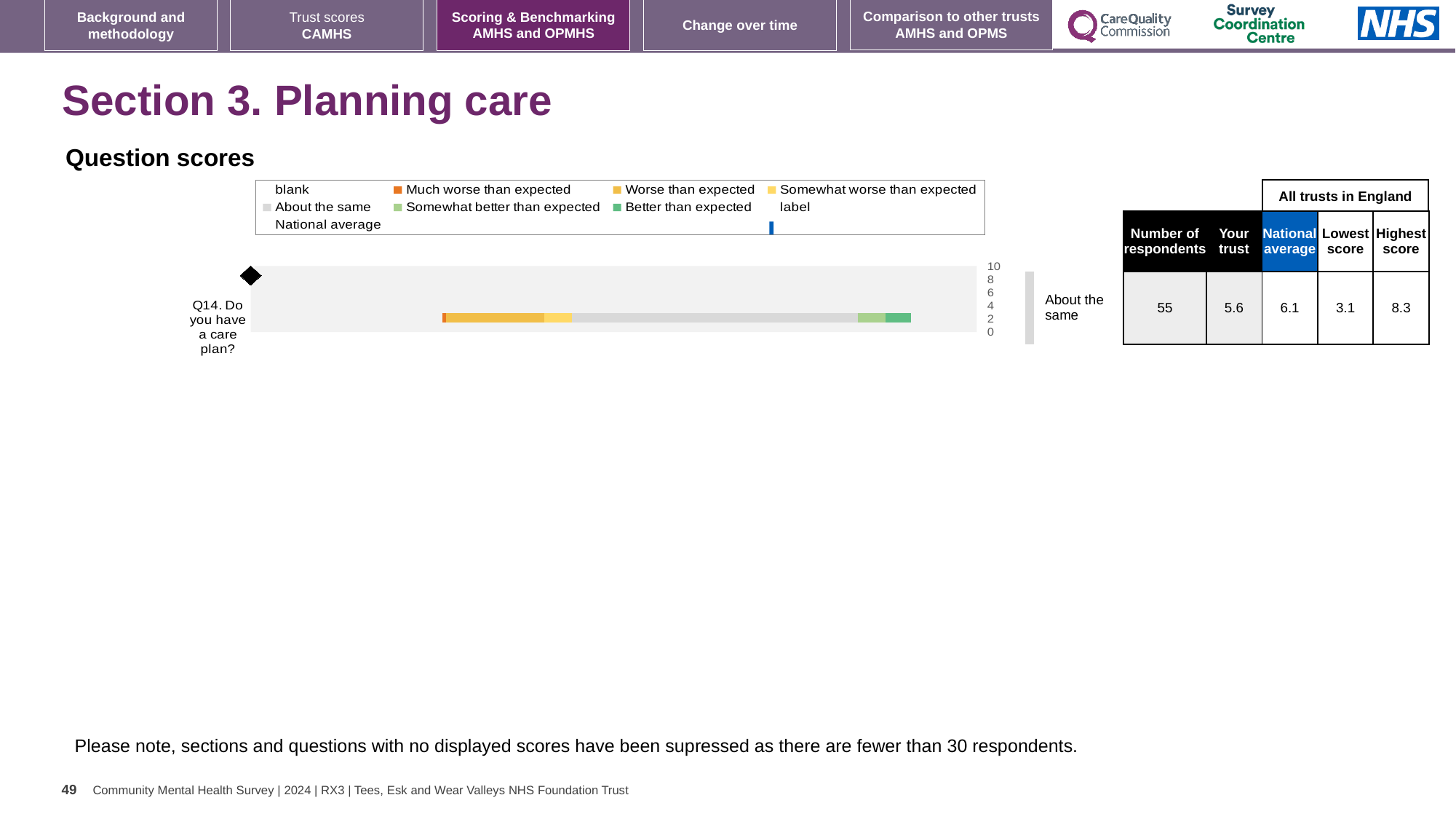
What is the highest score among all trusts in England for Q14? 8.3 By how much does the national average exceed the 'Your trust' score for Q14? 0.5 What is the national average score for Q14? 6.1 What kind of chart is used to show the Q14 question score? bar chart For Q14, which is larger: the 'Your trust' score or the national average? National average What is the full text of the question plotted in the chart? Q14. Do you have a care plan? How many questions are plotted in the Question scores chart? 1 How many respondents answered Q14? 55 What benchmark category is shown next to the Q14 bar? About the same What is the 'Your trust' score for Q14 (Do you have a care plan?)? 5.6 What is the lowest score among all trusts in England for Q14? 3.1 What is the difference between the highest and lowest scores for Q14 across all trusts in England? 5.2